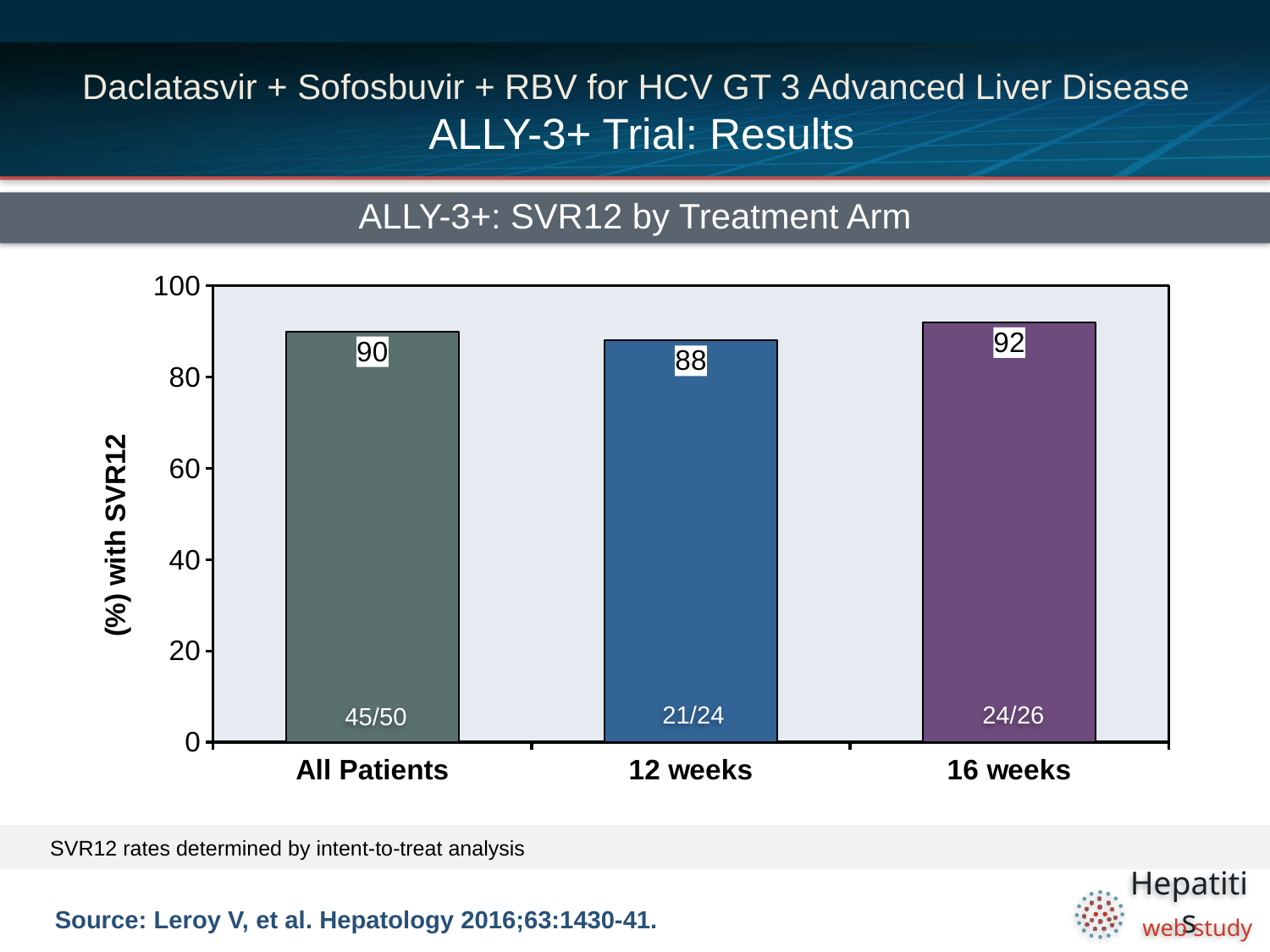
How many categories are shown on the x axis? 3 Is the SVR12 rate for the 12 weeks arm greater or less than 80? greater What is the SVR12 rate for the 12 weeks arm? 88 What is the SVR12 rate for All Patients? 90 What is the SVR12 rate for the 16 weeks arm? 92 Which category has the lowest SVR12 rate? 12 weeks Which has a higher SVR12 rate, All Patients or 16 weeks? 16 weeks Which treatment arm has the highest SVR12 rate? 16 weeks What is the difference in SVR12 rate between the 16 weeks and 12 weeks arms? 4 What kind of chart is shown on the slide? Bar chart What fraction of patients is shown inside the bar for the 12 weeks arm? 21/24 What is the title of the chart? ALLY-3+: SVR12 by Treatment Arm